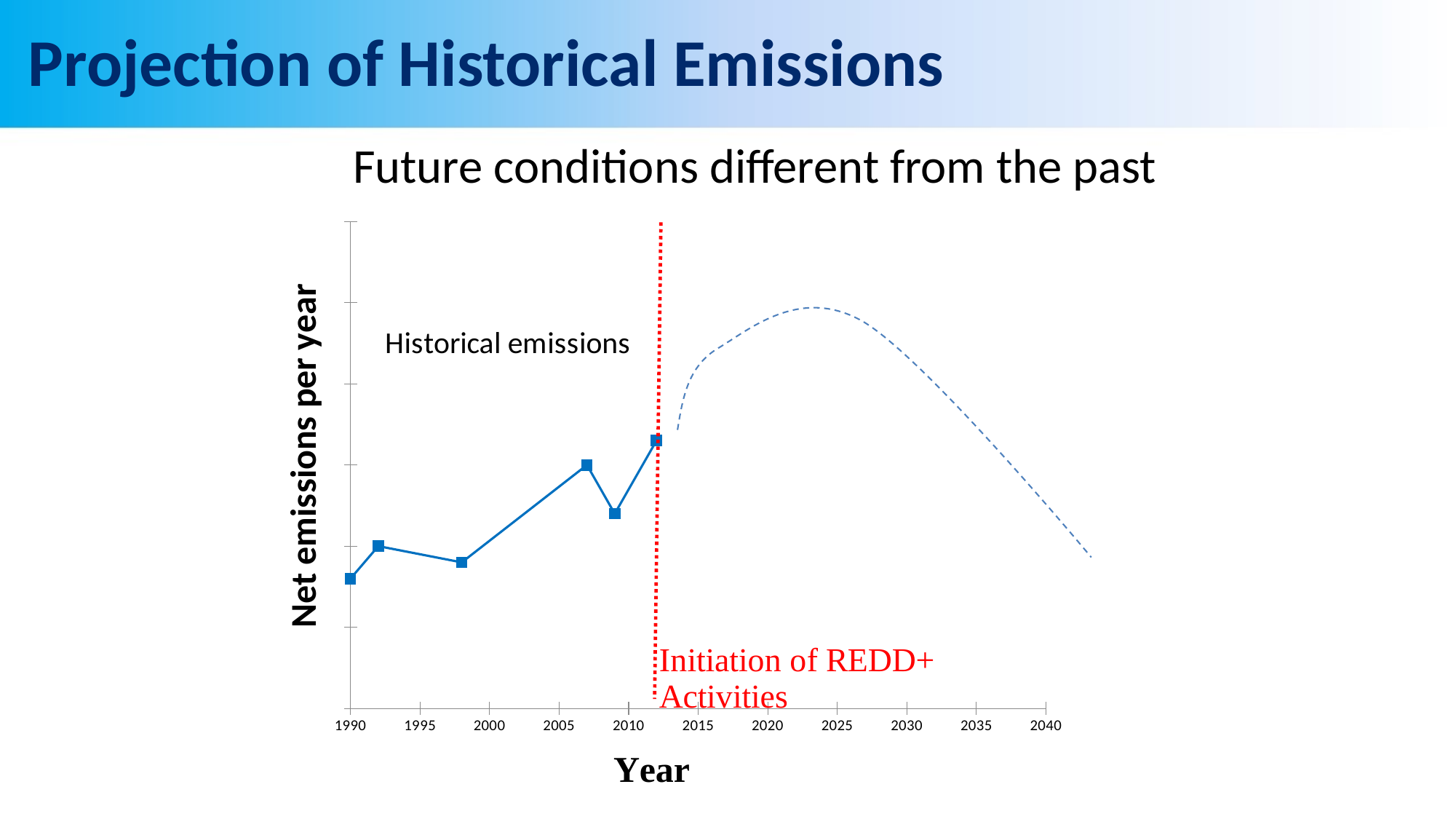
What is the label on the x axis of the chart? Year What kind of chart is shown on the slide? line chart Which plotted historical point is the highest: the first point (1990) or the last point (just after 2010)? the last point What is the label on the y axis of the chart? Net emissions per year Do the historical emissions generally rise or fall from 1990 to the last plotted point? rise Which plotted historical point is the lowest on the chart? the first point (1990) Of the two plotted points between 2005 and 2010, is the earlier one or the later one higher? the earlier one After the dotted red line, does the dashed projected curve first rise or fall? rise How many historical emission data points are plotted on the solid line? 6 Is the 1990 point higher or lower than the point plotted just after 1990? lower How many year labels are shown on the x axis? 11